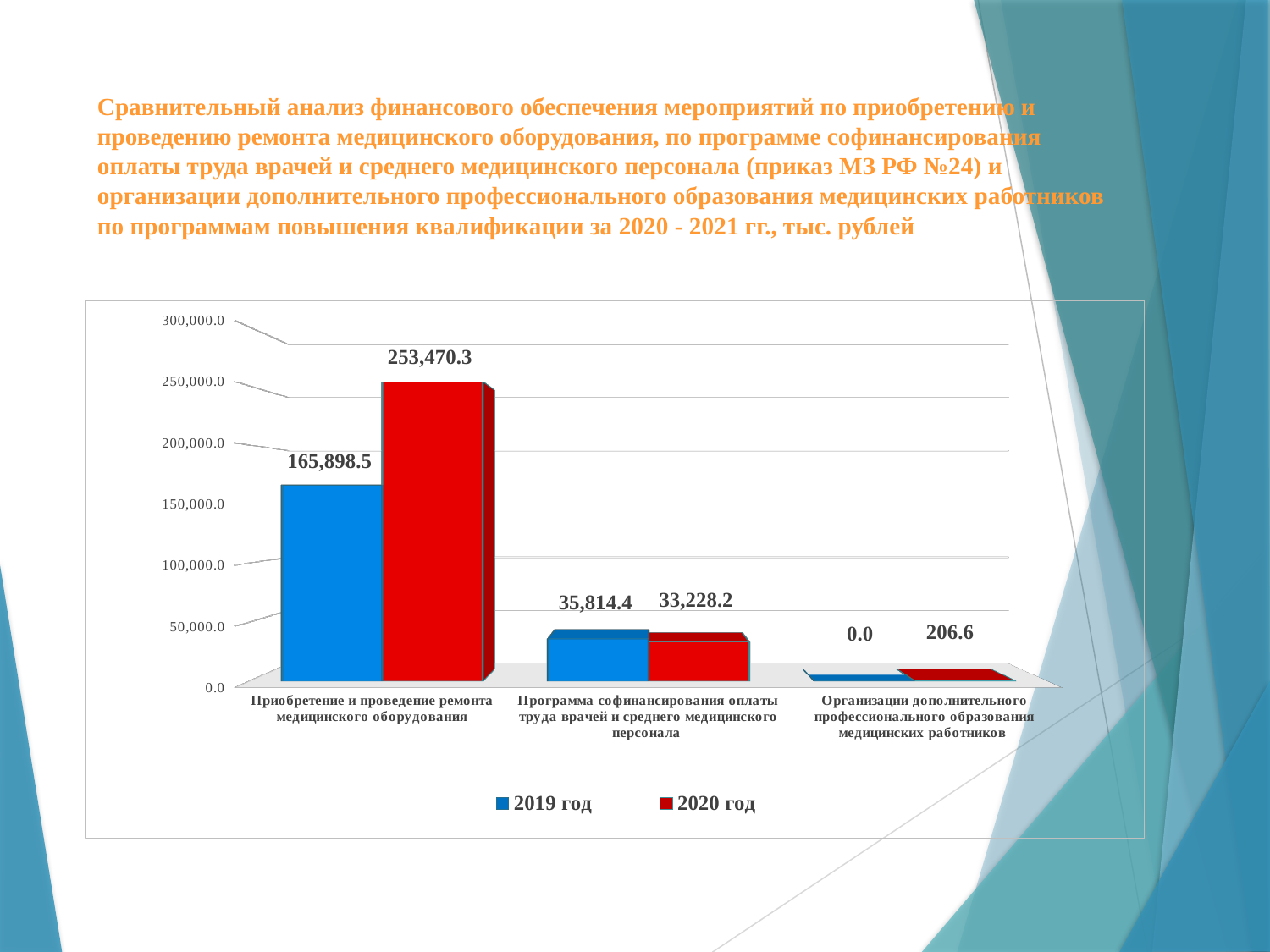
How many series does the chart legend list? 2 What type of chart is shown on the slide? Bar chart What is the difference between the 2020 год and 2019 год values for "Приобретение и проведение ремонта медицинского оборудования"? 87,571.8 What is the difference between the 2019 год and 2020 год values for "Программа софинансирования оплаты труда врачей и среднего медицинского персонала"? 2,586.2 For "Программа софинансирования оплаты труда врачей и среднего медицинского персонала", which is larger: the 2019 год value or the 2020 год value? 2019 год How many categories are shown on the x axis of the chart? 3 Which category has the lowest value for 2019 год? Организации дополнительного профессионального образования медицинских работников What is the value for 2019 год for "Приобретение и проведение ремонта медицинского оборудования"? 165,898.5 What is the value for 2020 год for "Организации дополнительного профессионального образования медицинских работников"? 206.6 Which category has the highest value for 2020 год? Приобретение и проведение ремонта медицинского оборудования What is the value for 2019 год for "Программа софинансирования оплаты труда врачей и среднего медицинского персонала"? 35,814.4 What is the value for 2020 год for "Приобретение и проведение ремонта медицинского оборудования"? 253,470.3